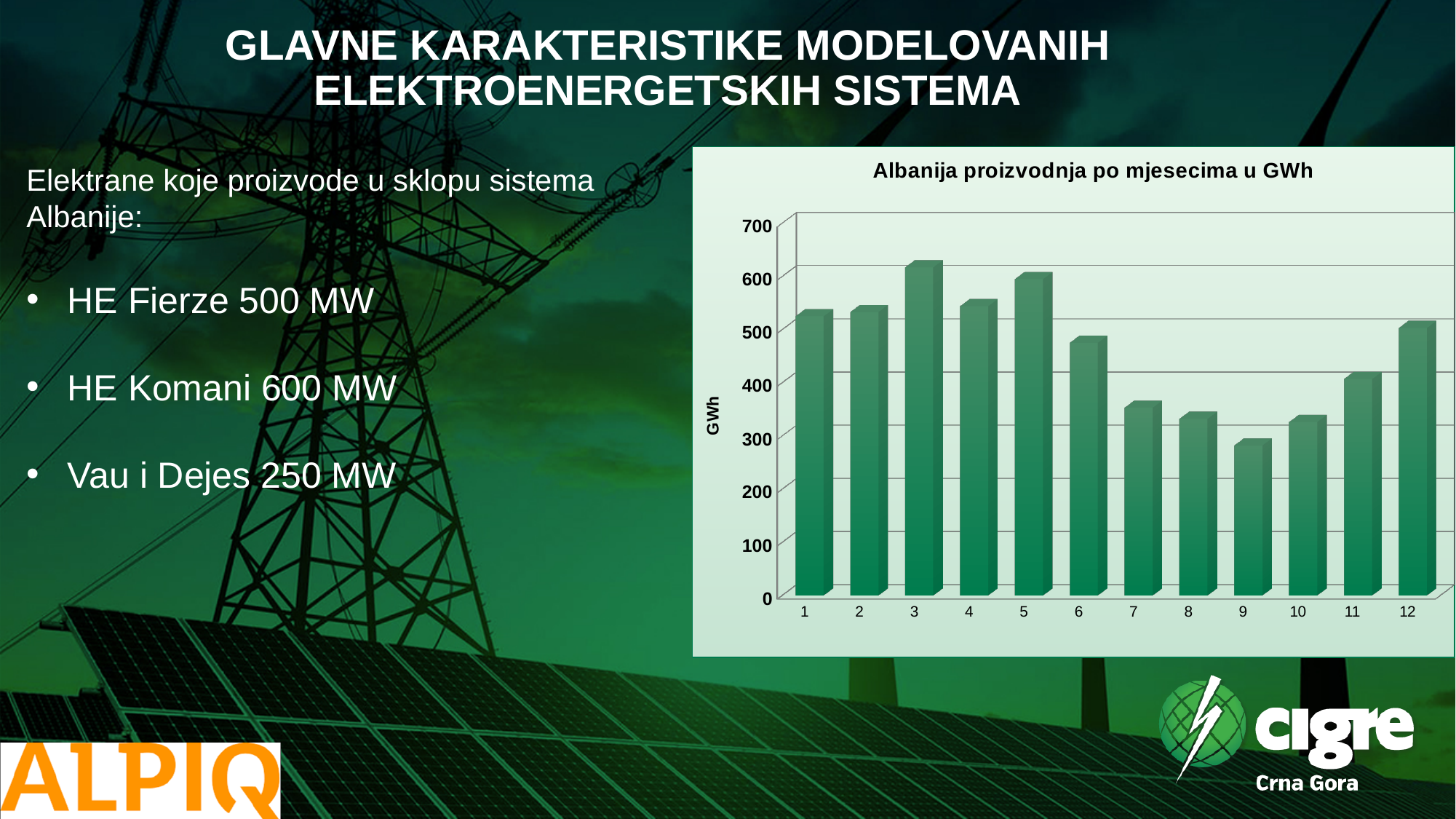
How many months (categories) are plotted on the x axis of the chart? 12 Which is larger, the value for month 6 or the value for month 7? month 6 Do the values rise or fall from month 3 to month 9? fall What is the label on the vertical axis of the chart? GWh What type of chart is shown on the slide? bar chart What is the title of the chart? Albanija proizvodnja po mjesecima u GWh Is the value for month 6 greater or less than 500? less Which month has the lowest production in the chart? 9 Is the value for month 7 greater or less than 400? less Which month has the highest production in the chart? 3 Is the value for month 3 greater or less than 600? greater